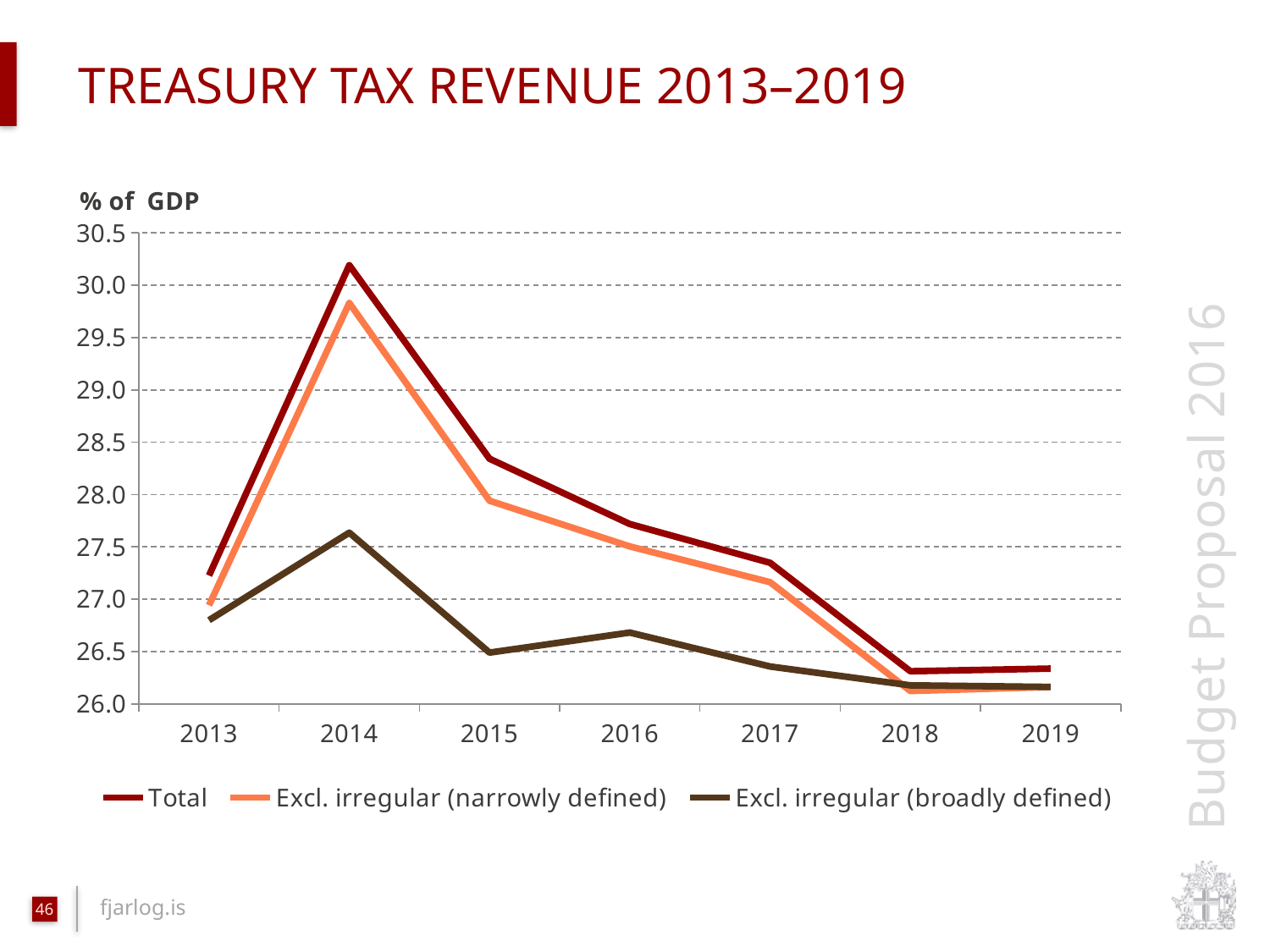
In which year does the Excl. irregular (broadly defined) series reach its highest value? 2014 Is the value for Excl. irregular (narrowly defined) in 2014 greater or less than 30.0? less Is the value for Excl. irregular (broadly defined) in 2015 greater or less than 27.0? less What type of chart is shown on the slide? line chart Does the Total series rise or fall from 2014 to 2018? fall Is the value for Total in 2013 greater or less than 27.0? greater In 2015, which is larger: Total or Excl. irregular (narrowly defined)? Total How many years are shown on the x axis? 7 In which year does the Total series reach its highest value? 2014 How many series does the legend list? 3 What unit is shown above the y axis? % of GDP